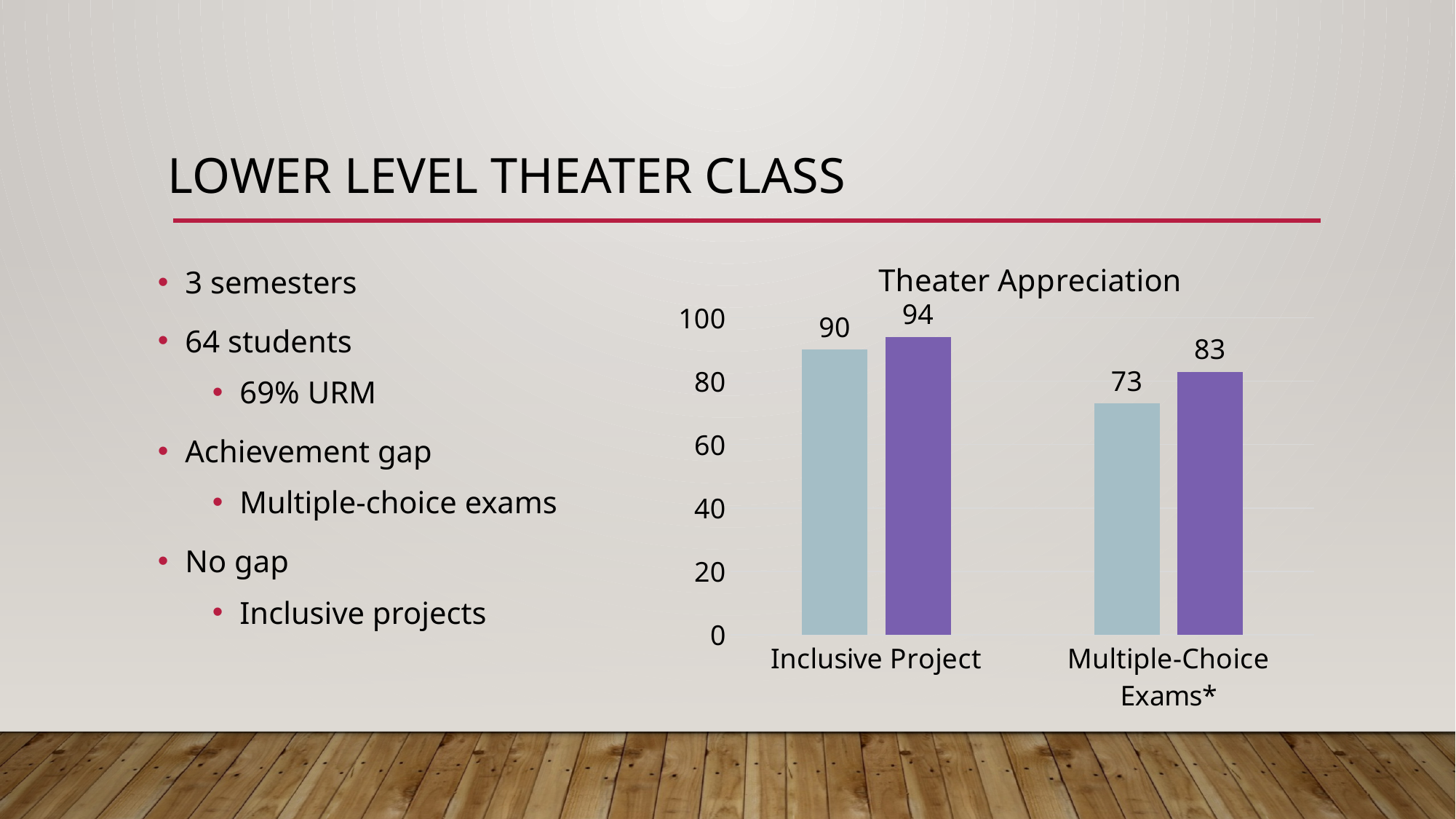
What is the value of the purple bar for Inclusive Project? 94 How many categories are shown on the x axis of the chart? 2 What is the difference between the purple and light blue bars for Inclusive Project? 4 Which bar in the chart has the lowest value? the light blue bar for Multiple-Choice Exams* (73) What is the value of the light blue bar for Multiple-Choice Exams*? 73 What is the difference between the purple and light blue bars for Multiple-Choice Exams*? 10 What is the value of the purple bar for Multiple-Choice Exams*? 83 What kind of chart is shown on the slide? bar chart Which is larger: the light blue bar for Inclusive Project or the purple bar for Multiple-Choice Exams*? the light blue bar for Inclusive Project What is the title of the chart? Theater Appreciation Which bar in the chart has the highest value? the purple bar for Inclusive Project (94) What is the value of the light blue bar for Inclusive Project? 90